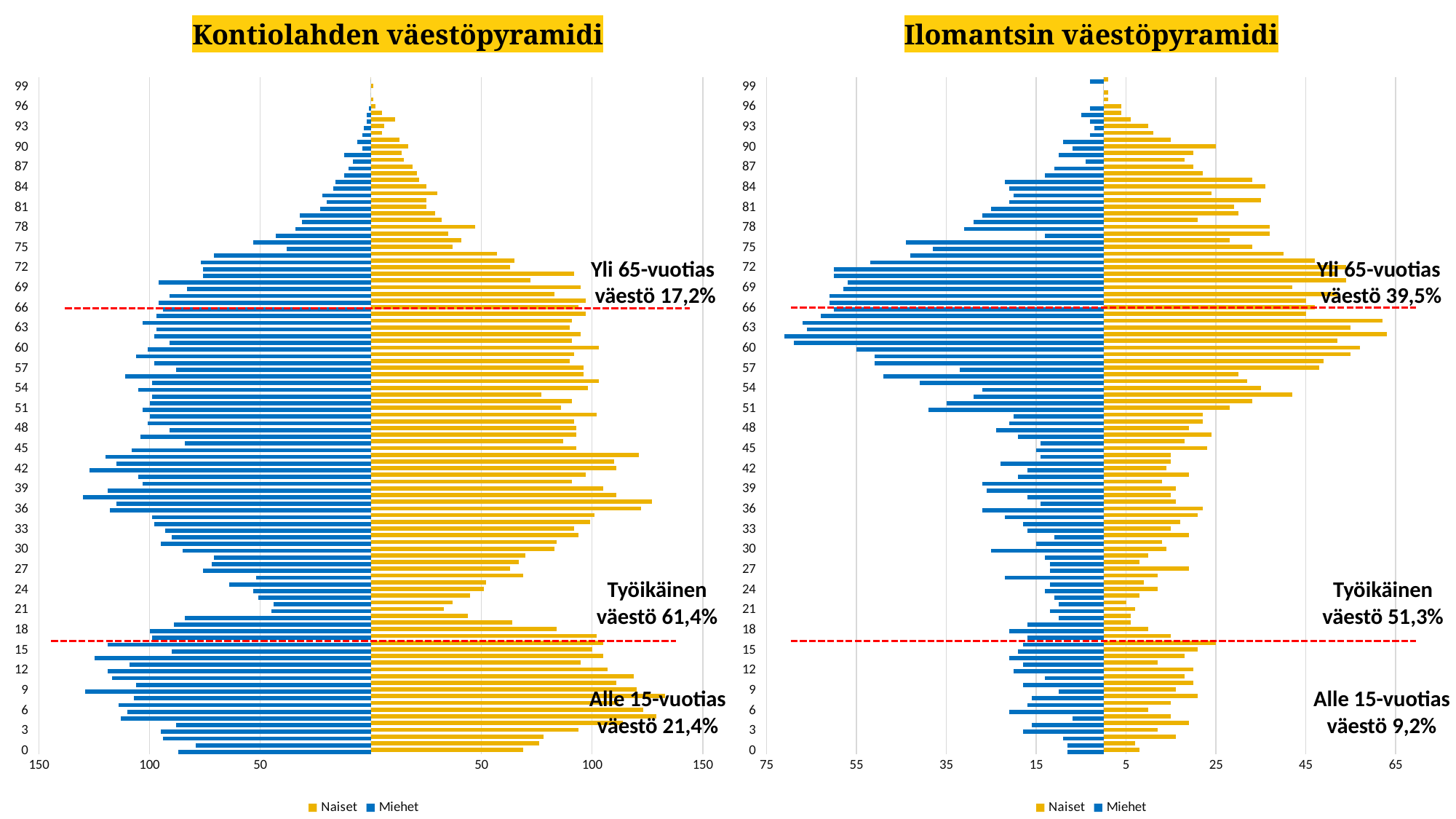
Which municipality has the larger share of over-65 population, Kontiolahti or Ilomantsi? Ilomantsi On the Kontiolahden väestöpyramidi chart, is the Miehet value for age 39 greater or less than 100? greater What is the difference between the over-65 population shares of Ilomantsi (39,5%) and Kontiolahti (17,2%)? 22,3% On the Kontiolahden väestöpyramidi chart, what share of the population is over 65 years old (Yli 65-vuotias väestö)? 17,2% On the Kontiolahden väestöpyramidi chart, is the Naiset value for age 21 greater or less than 50? less What kind of chart is the Ilomantsin väestöpyramidi chart? Bar chart On the Ilomantsin väestöpyramidi chart, what share of the population is of working age (Työikäinen väestö)? 51,3% On the Ilomantsin väestöpyramidi chart, is the Miehet value for age 61 greater or less than 55? greater On the Ilomantsin väestöpyramidi chart, what share of the population is over 65 years old (Yli 65-vuotias väestö)? 39,5% How many series does the legend of the Kontiolahden väestöpyramidi chart list? 2 What is the difference between the under-15 population shares of Kontiolahti (21,4%) and Ilomantsi (9,2%)? 12,2% On the Kontiolahden väestöpyramidi chart, what share of the population is under 15 years old (Alle 15-vuotias väestö)? 21,4%